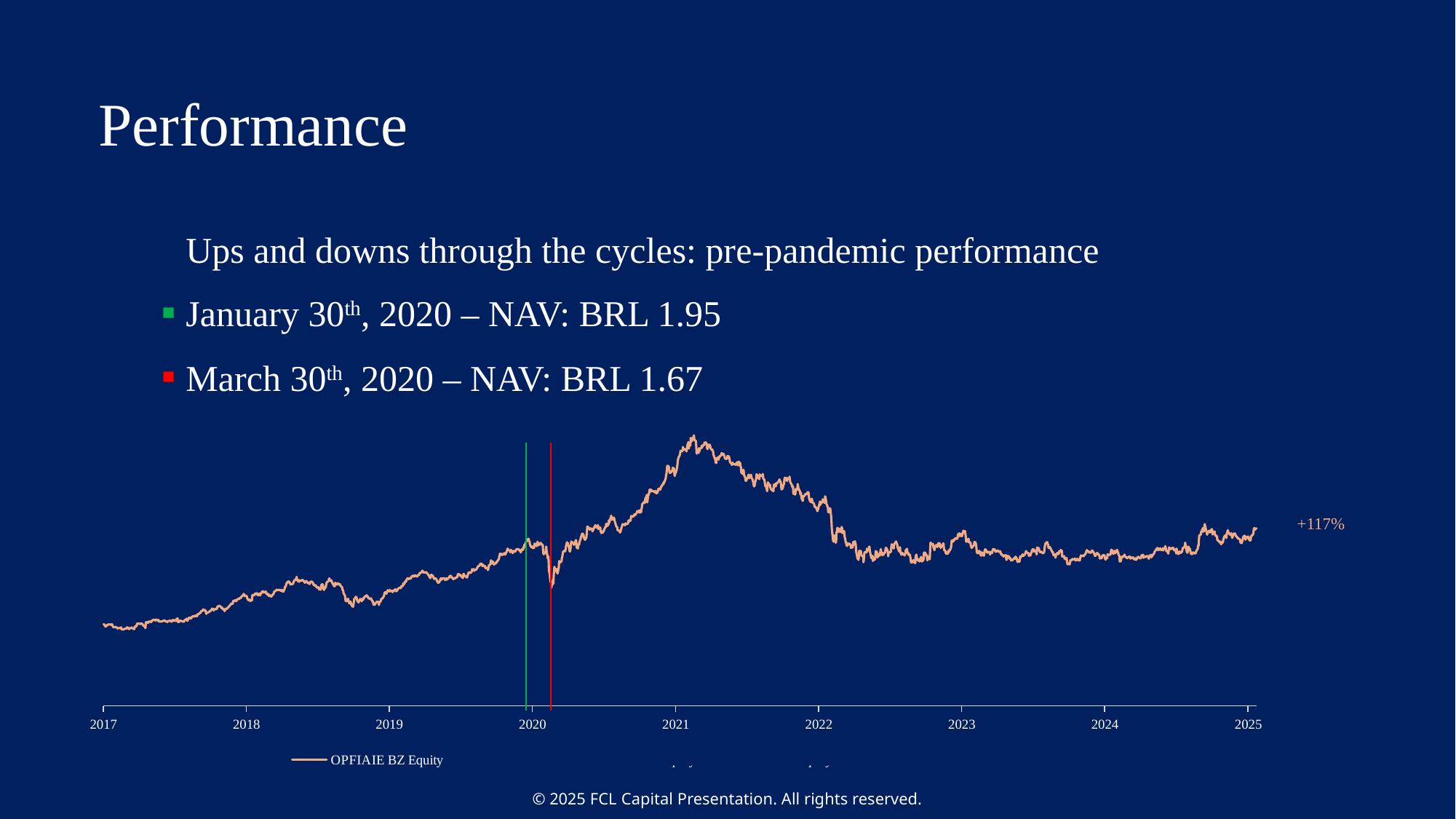
What was the NAV on March 30th, 2020, marked by the red vertical line? BRL 1.67 What was the NAV on January 30th, 2020, marked by the green vertical line? BRL 1.95 What is the name of the series shown in the chart legend? OPFIAIE BZ Equity What percentage label is printed at the right end of the line? +117% How many year labels are shown on the x axis? 9 What is the difference between the NAV on January 30th, 2020 and the NAV on March 30th, 2020? BRL 0.28 Overall, does the line end higher or lower in 2025 than it started in 2017? higher How many series does the chart legend list? 1 In which year labelled on the x axis does the line reach its highest point? 2021 Which was higher, the NAV on January 30th, 2020 or the NAV on March 30th, 2020? January 30th, 2020 What kind of chart is shown on the slide? line chart Does the line rise or fall between the 2021 and 2022 ticks on the x axis? fall